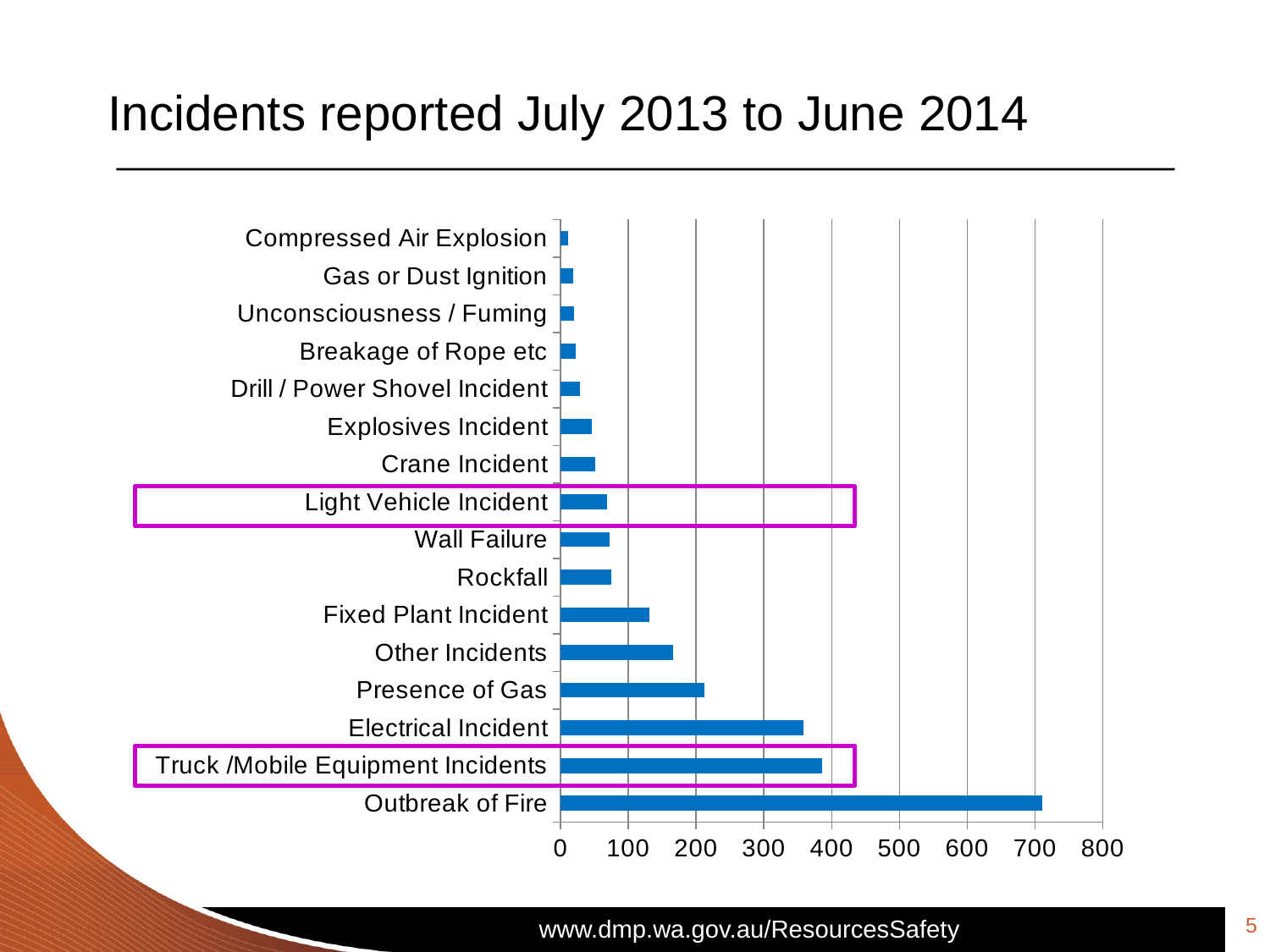
Is the value for Rockfall greater or less than 100? less Which incident category has the highest number of reported incidents? Outbreak of Fire What is the title of the chart on the slide? Incidents reported July 2013 to June 2014 Is the value for Electrical Incident greater or less than 300? greater Is the value for Fixed Plant Incident greater or less than 100? greater How many incident categories are plotted in the chart? 16 Which incident category has the lowest number of reported incidents? Compressed Air Explosion Which has more reported incidents, Electrical Incident or Presence of Gas? Electrical Incident Which two incident categories are highlighted with magenta boxes on the chart? Light Vehicle Incident and Truck /Mobile Equipment Incidents What kind of chart is shown on the slide? bar chart